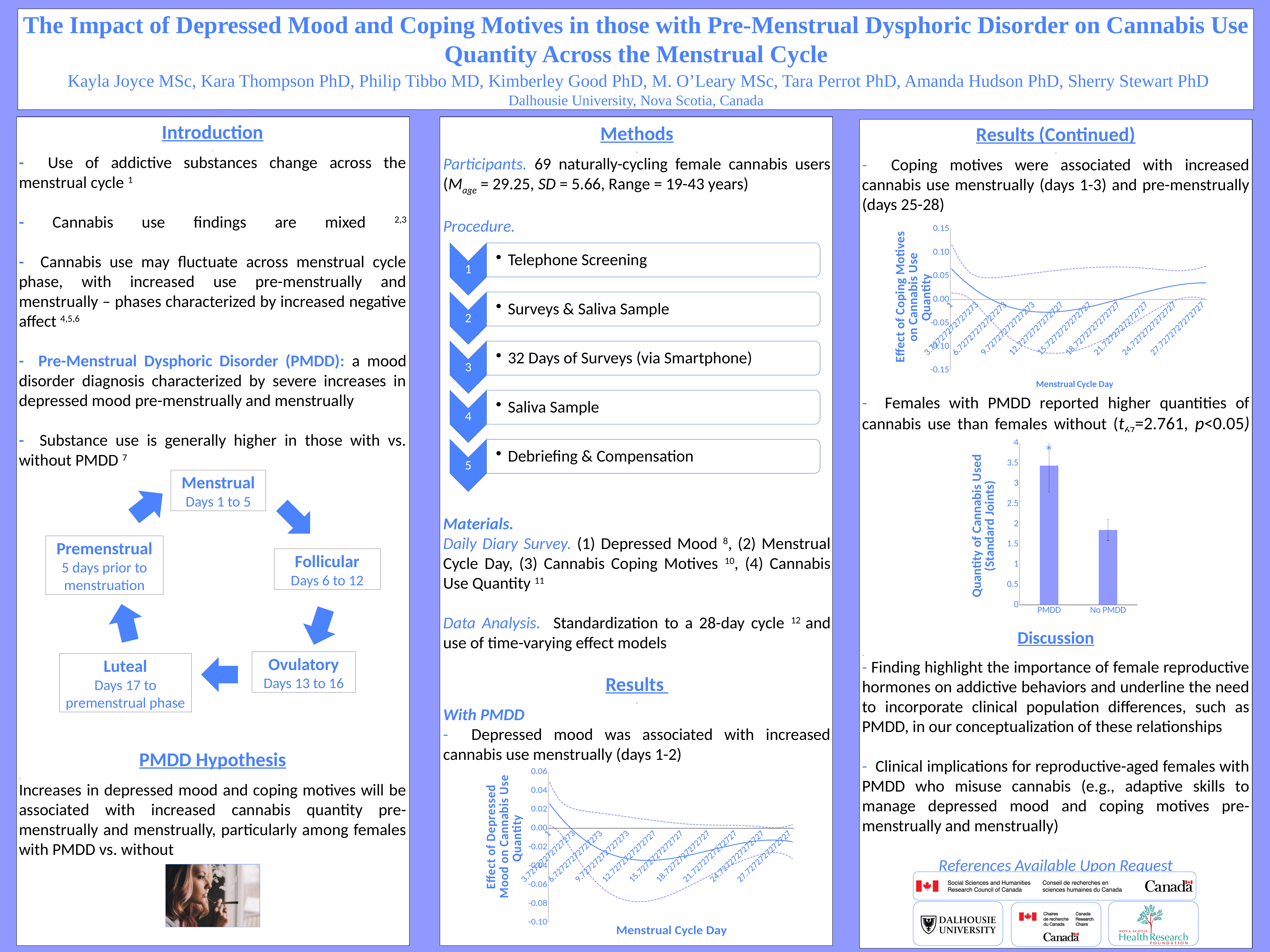
In the chart labelled 'Effect of Depressed Mood on Cannabis Use Quantity', is the solid line at the start of the cycle greater or less than 0.00? greater In the bar chart of Quantity of Cannabis Used, how many groups are shown on the x axis? 2 In the chart labelled 'Effect of Coping Motives on Cannabis Use Quantity', what is the highest value shown on the y axis? 0.15 In the bar chart of Quantity of Cannabis Used, which group has the lower bar? No PMDD In the chart labelled 'Effect of Coping Motives on Cannabis Use Quantity', does the solid line rise or fall over the first few cycle days? fall In the bar chart of Quantity of Cannabis Used, is the value for PMDD greater or less than 3? greater What kind of chart is the chart titled 'Quantity of Cannabis Used (Standard Joints)' in the Results (Continued) section? bar chart What is the x-axis title of the chart labelled 'Effect of Depressed Mood on Cannabis Use Quantity'? Menstrual Cycle Day What kind of chart is the chart labelled 'Effect of Depressed Mood on Cannabis Use Quantity' in the Results section? line chart In the bar chart of Quantity of Cannabis Used, is the value for No PMDD greater or less than 2? less In the bar chart of Quantity of Cannabis Used, which group has the higher bar? PMDD In the bar chart of Quantity of Cannabis Used, is the bar for PMDD larger or smaller than the bar for No PMDD? larger